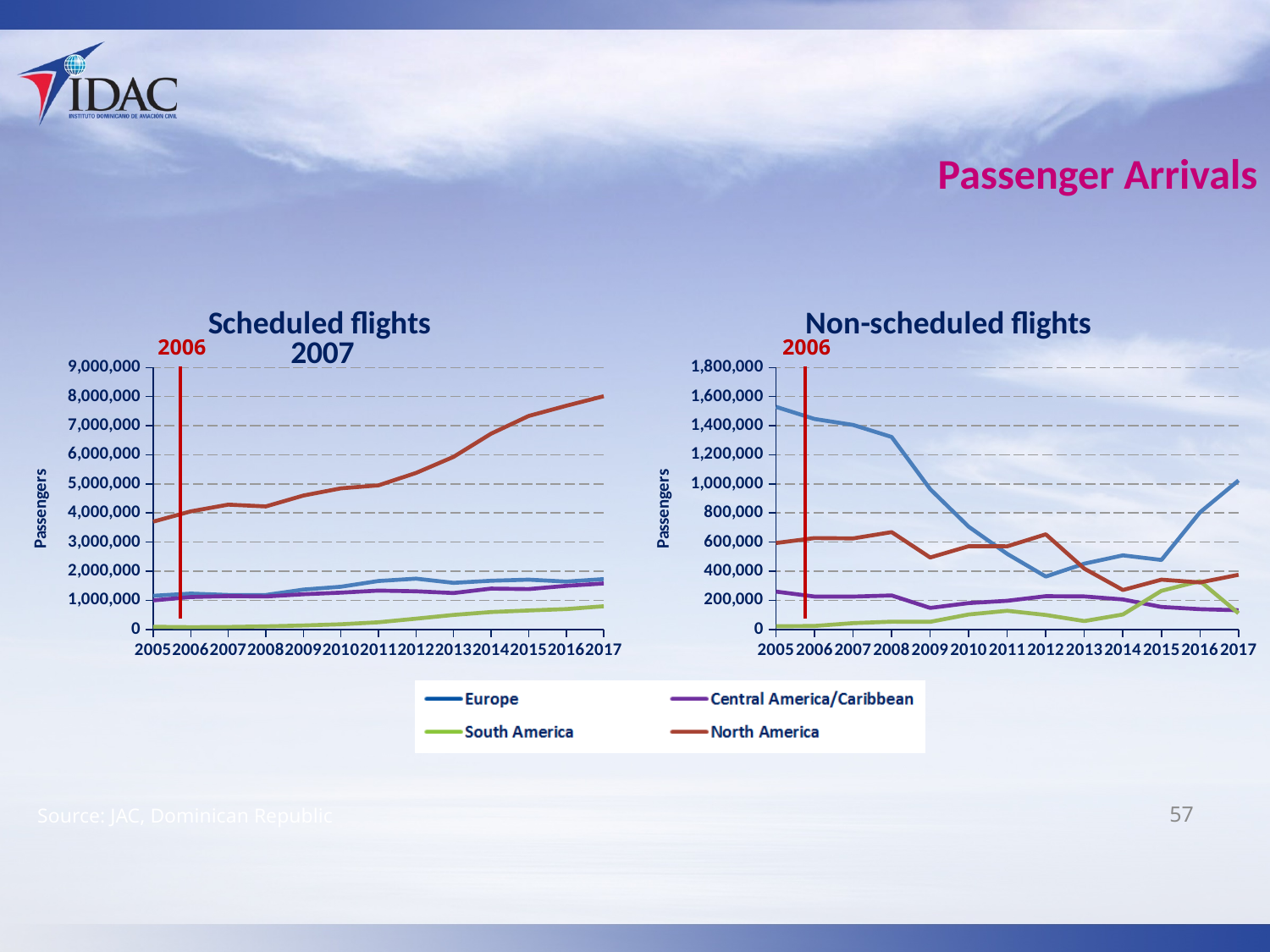
What is the label on the y axis of both charts? Passengers In the Scheduled flights chart, is the value for Europe in 2005 greater or less than 2,000,000? less In the Scheduled flights chart, which series has the highest value in 2017? North America In the Scheduled flights chart, is the value for North America in 2017 greater or less than 7,000,000? greater In the Scheduled flights chart, does the North America series rise or fall from 2005 to 2017? Rise In the Non-scheduled flights chart, which series has the highest value in 2005? Europe What kind of chart is the Scheduled flights chart? Line chart In the Non-scheduled flights chart, is the value for Europe in 2012 greater or less than 600,000? less In the Scheduled flights chart, which series has the lowest value in 2017? South America How many years are plotted along the x axis of the Non-scheduled flights chart? 13 In the Non-scheduled flights chart, which is larger in 2017, Europe or North America? Europe How many series does the legend list? 4